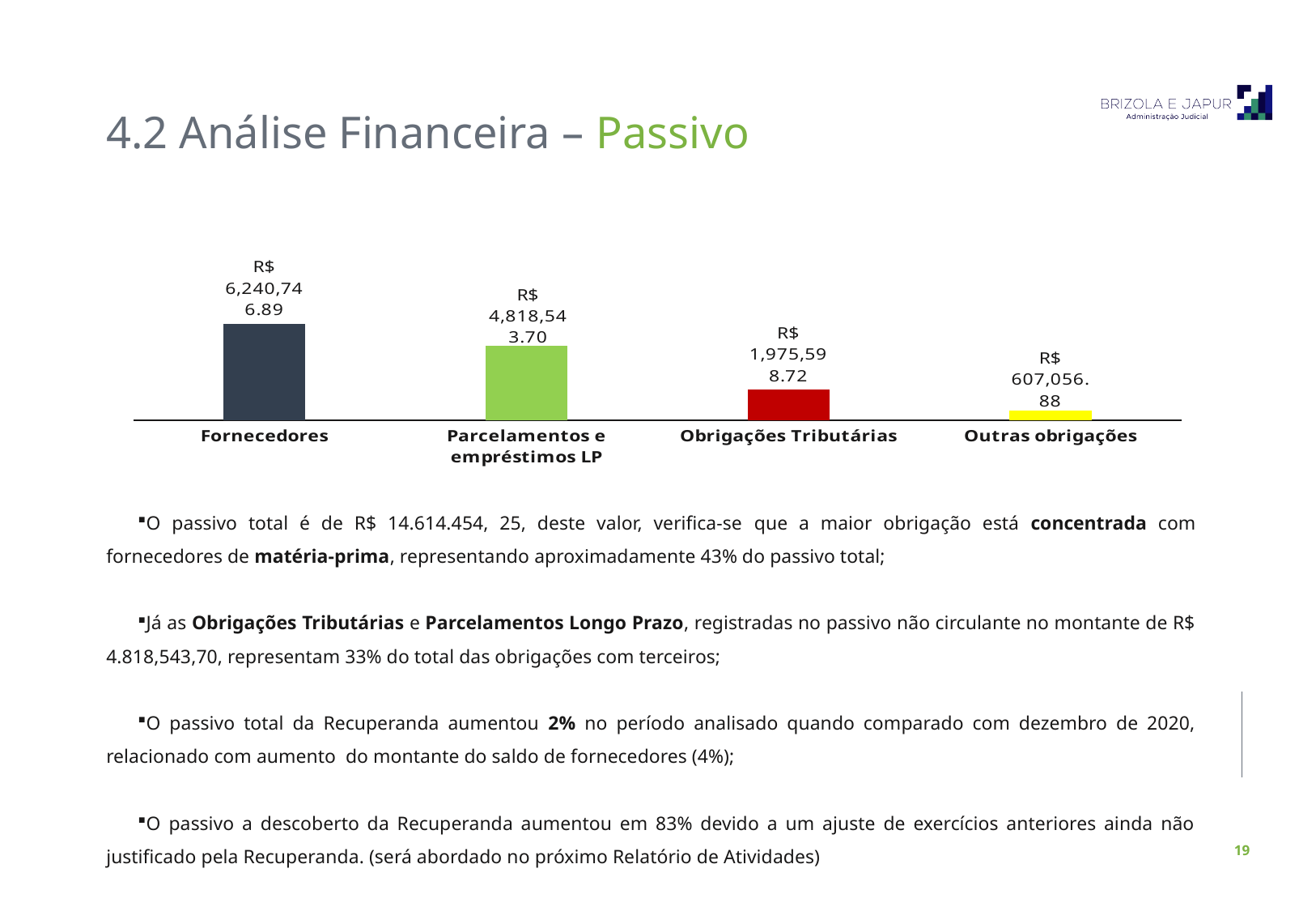
Which category has the highest value? Fornecedores Which category has the lowest value? Outras obrigações What is the value for Outras obrigações? R$ 607,056.88 What is the value for Parcelamentos e empréstimos LP? R$ 4,818,543.70 What is the value for Fornecedores? R$ 6,240,746.89 What is the difference between the values for Fornecedores and Parcelamentos e empréstimos LP? R$ 1,422,203.19 What is the difference between the values for Obrigações Tributárias and Outras obrigações? R$ 1,368,541.84 What is the value for Obrigações Tributárias? R$ 1,975,598.72 Do the values rise or fall from left to right across the categories? Fall Which is larger, the value for Parcelamentos e empréstimos LP or the value for Obrigações Tributárias? Parcelamentos e empréstimos LP How many categories are shown in the chart? 4 What kind of chart is shown on the slide? Bar chart